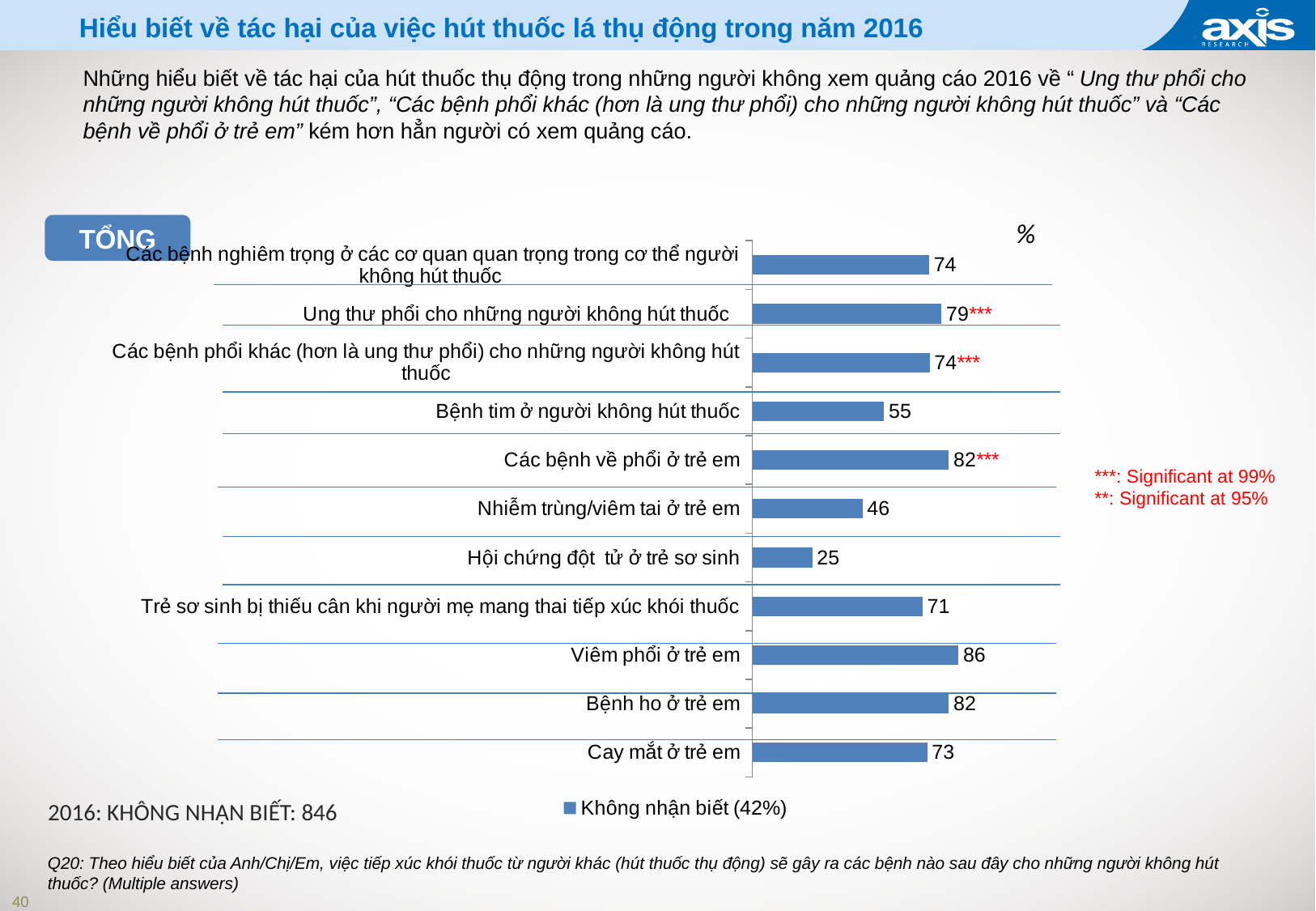
What is the value for "Viêm phổi ở trẻ em"? 86 Which category has the highest value? Viêm phổi ở trẻ em Which is larger: the value for "Các bệnh về phổi ở trẻ em" or the value for "Cay mắt ở trẻ em"? Các bệnh về phổi ở trẻ em What is the difference between the values for "Viêm phổi ở trẻ em" and "Nhiễm trùng/viêm tai ở trẻ em"? 40 What is the legend entry of the chart? Không nhận biết (42%) What is the value for "Ung thư phổi cho những người không hút thuốc"? 79 What is the value for "Hội chứng đột tử ở trẻ sơ sinh"? 25 Which category has the lowest value? Hội chứng đột tử ở trẻ sơ sinh What kind of chart is shown on the slide? Bar chart How many categories are shown in the chart? 11 What is the value for "Bệnh tim ở người không hút thuốc"? 55 How many series does the legend list? 1